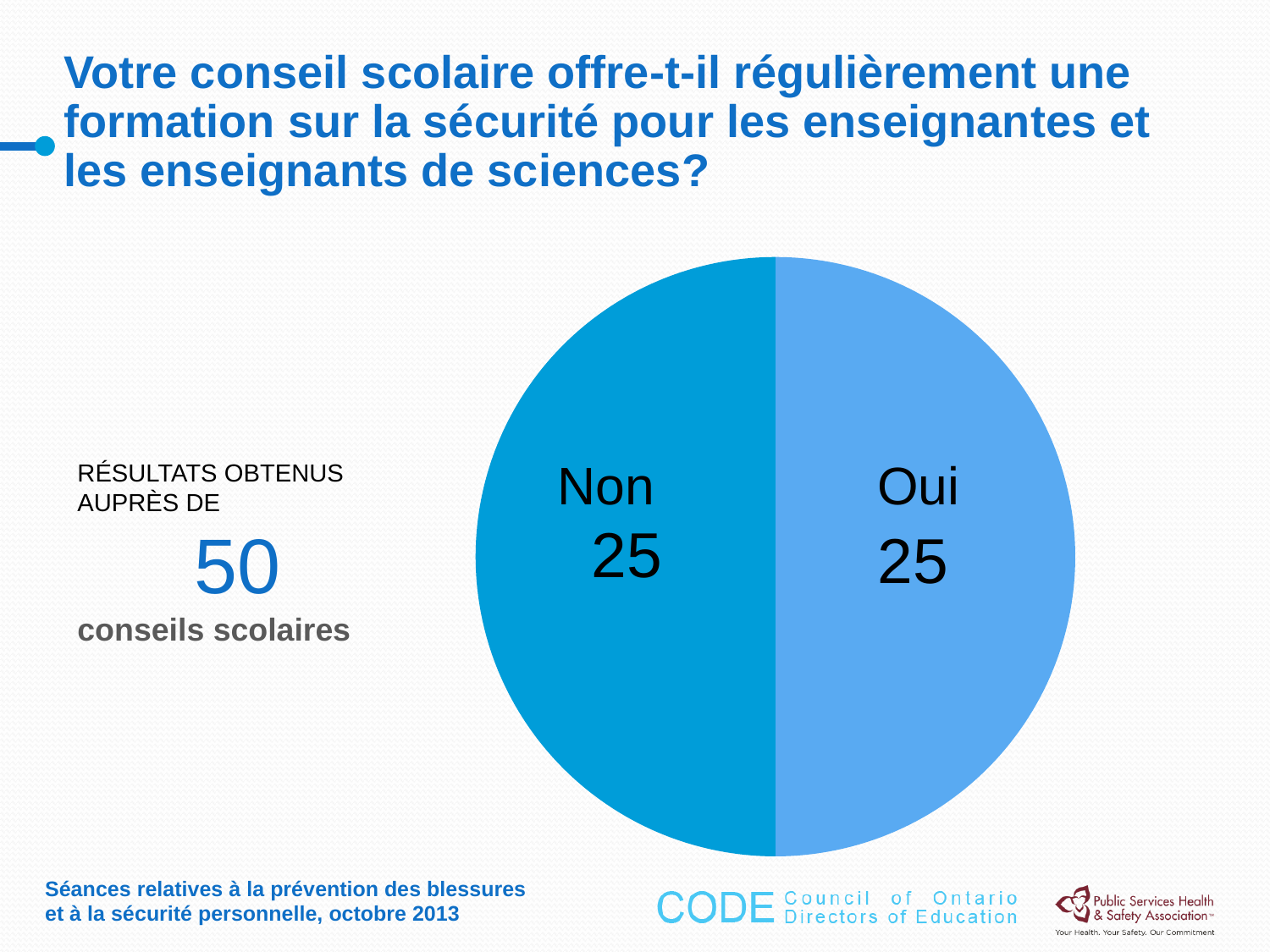
What is the difference between the Non and Oui values? 0 What share of the pie does the Non slice represent? 50% What share of the pie does the Oui slice represent? 50% What is the value for Oui in the pie chart? 25 What kind of chart is shown on the slide? pie chart How many slices does the pie chart have? 2 How many school boards (conseils scolaires) do the results come from, according to the slide? 50 Which slice is on the left side of the pie chart? Non What is the value for Non in the pie chart? 25 What is the total of the Non and Oui values in the pie chart? 50 Is the value for Non greater or less than 20? greater